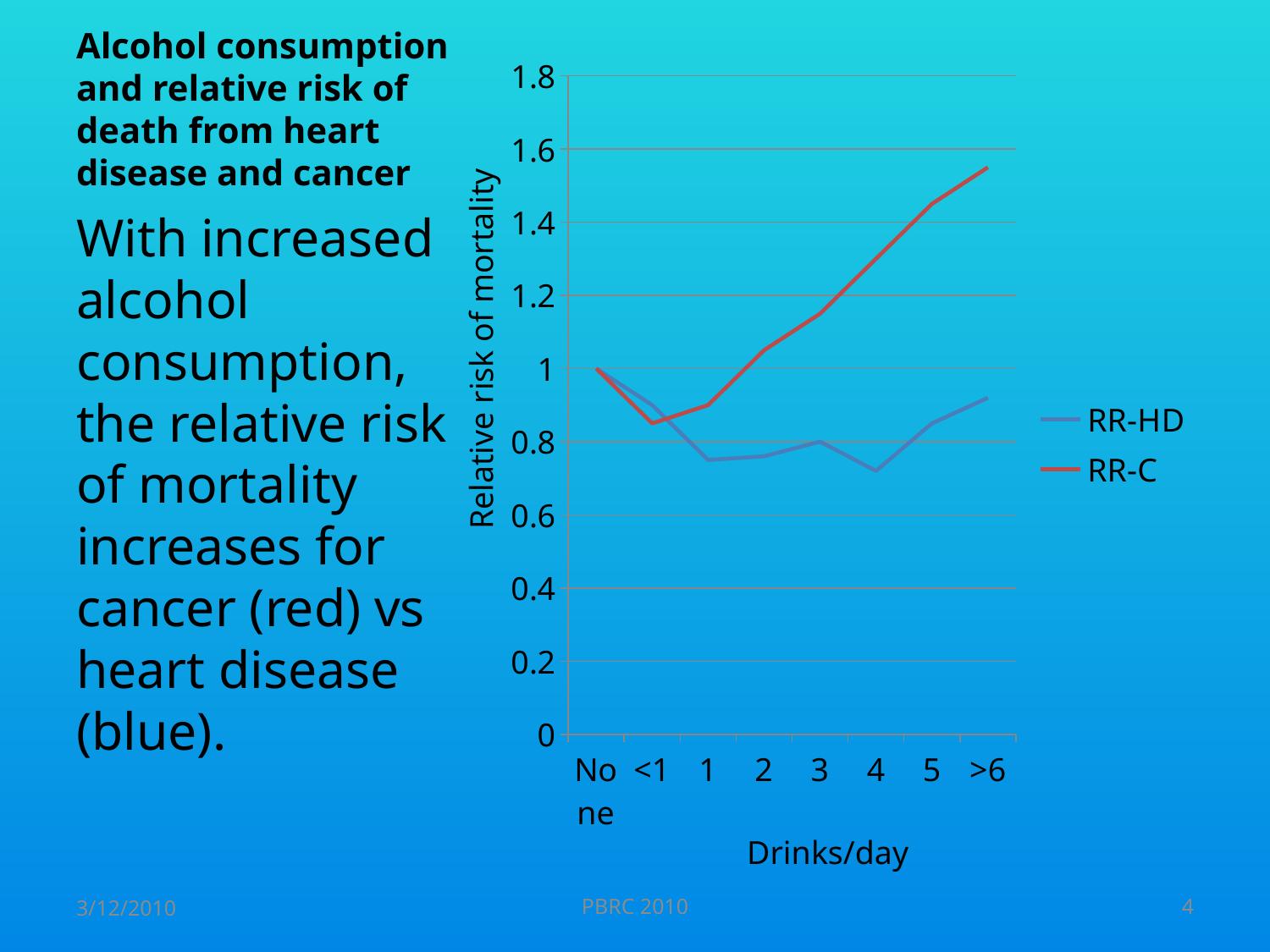
How many series does the legend list? 2 At which drinks/day category is the RR-HD line lowest? 4 Is the value for RR-C at >6 drinks/day greater or less than 1.4? greater What kind of chart is shown on the slide? line chart How many categories are shown on the x axis (Drinks/day)? 8 Is the value for RR-C at 3 drinks/day greater or less than 1? greater Is the value for RR-HD at 1 drink/day greater or less than 0.8? less Does the RR-C line rise or fall from 1 drink/day to >6 drinks/day? rises What is the title of the horizontal axis? Drinks/day At which drinks/day category is the RR-C line highest? >6 At 5 drinks/day, which series has the larger value, RR-HD or RR-C? RR-C What is the title of the vertical axis? Relative risk of mortality